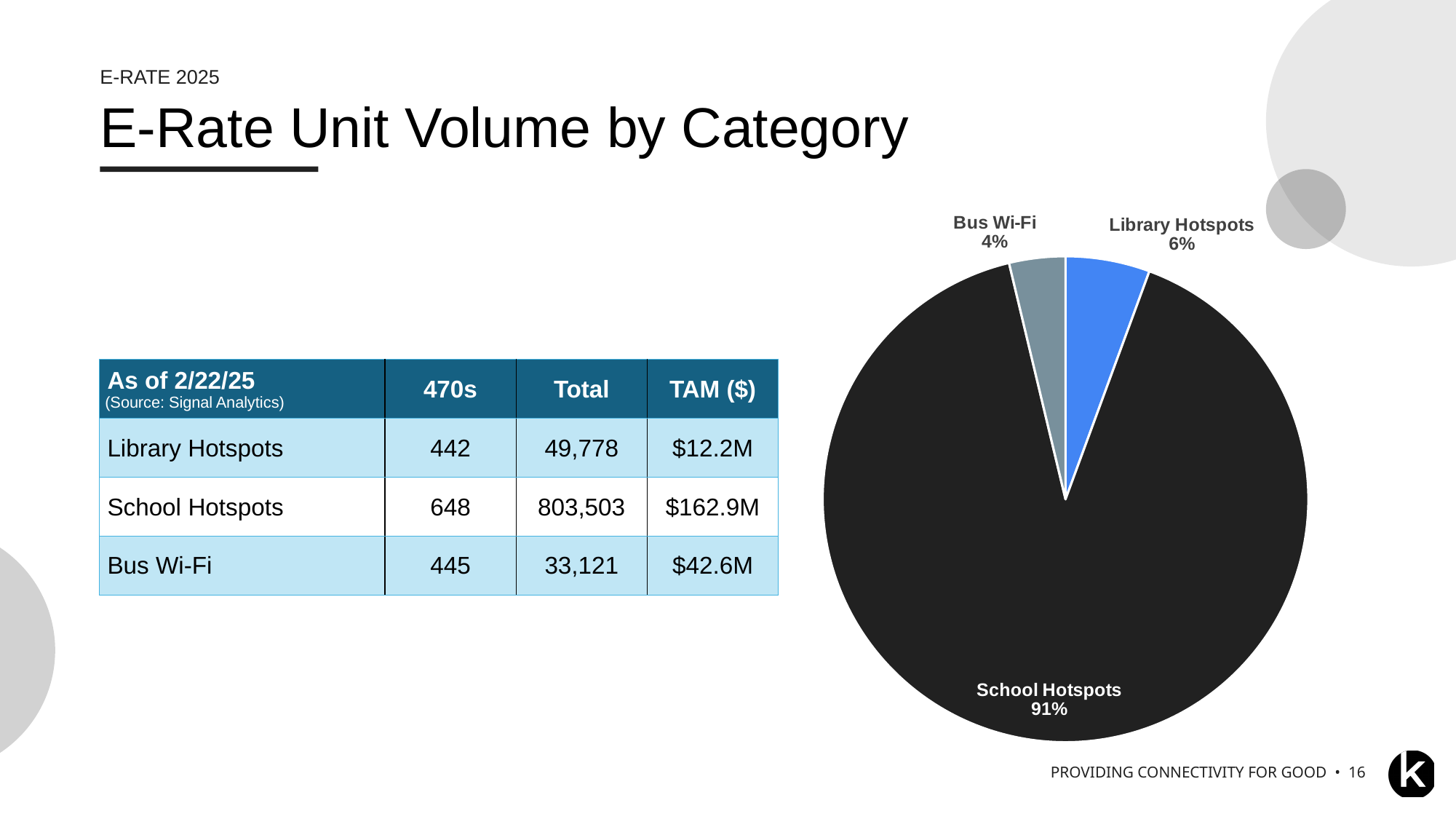
Which slice is larger, Library Hotspots or Bus Wi-Fi? Library Hotspots What is the difference in percentage points between the Library Hotspots slice and the Bus Wi-Fi slice? 2 What share of the pie does Bus Wi-Fi represent? 4% What is the difference in percentage points between the School Hotspots slice and the Library Hotspots slice? 85 Which category has the smallest slice of the pie? Bus Wi-Fi What kind of chart is shown on the slide? pie chart How many slices does the pie chart have? 3 What colour is the Library Hotspots slice of the pie? blue What colour is the School Hotspots slice of the pie? black Which category has the largest slice of the pie? School Hotspots What share of the pie does School Hotspots represent? 91% What share of the pie does Library Hotspots represent? 6%